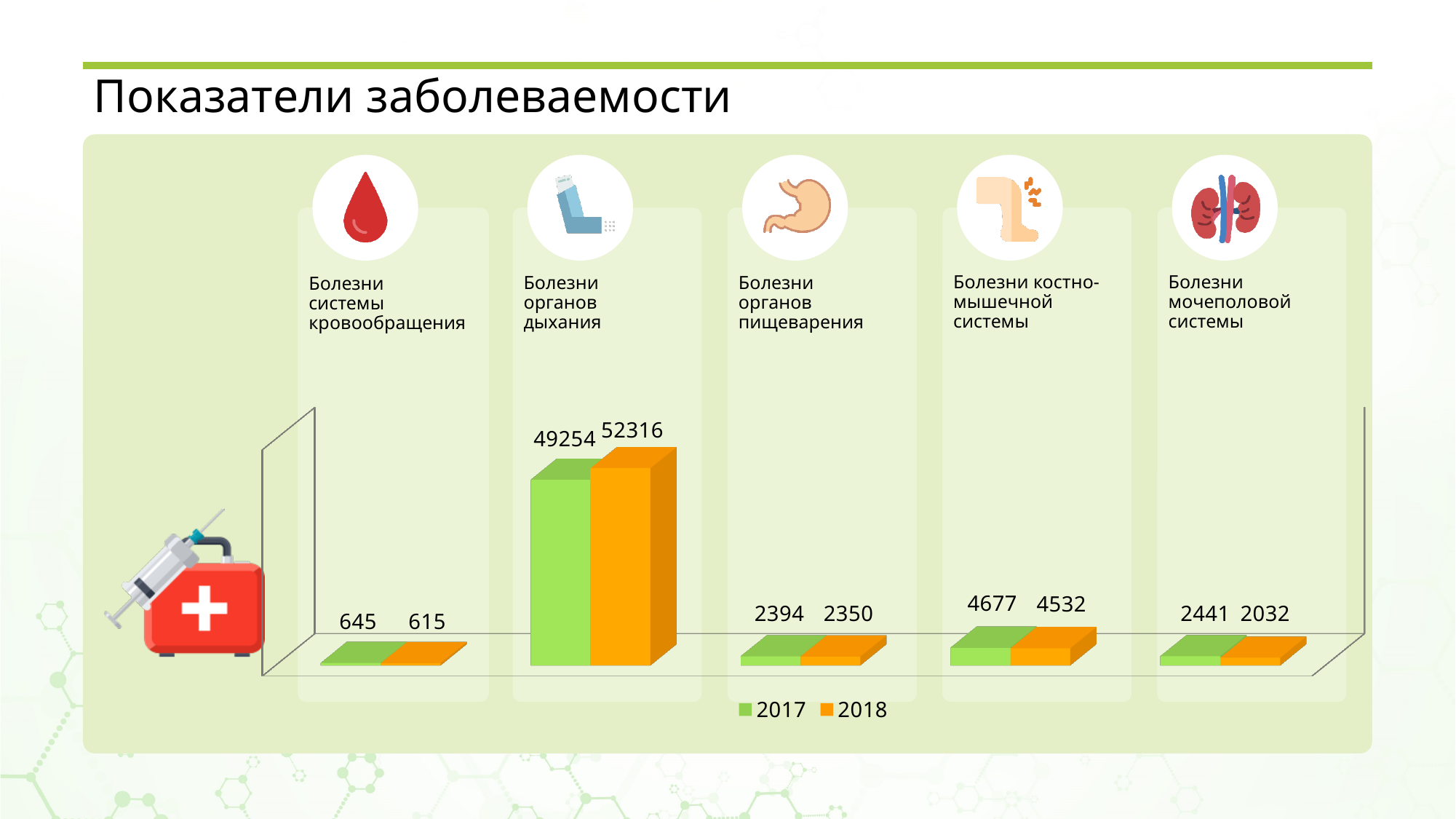
Which category has the lowest 2017 value? Болезни системы кровообращения How many disease categories are shown in the chart? 5 Which is larger for Болезни органов пищеварения: the 2017 value or the 2018 value? 2017 Which category has the highest 2018 value? Болезни органов дыхания What is the 2017 value for Болезни органов дыхания? 49254 What kind of chart is shown on the slide? Bar chart What is the difference between the 2017 and 2018 values for Болезни мочеполовой системы? 409 What is the 2017 value for Болезни костно-мышечной системы? 4677 What is the difference between the 2018 and 2017 values for Болезни органов дыхания? 3062 What is the 2018 value for Болезни мочеполовой системы? 2032 What is the 2018 value for Болезни системы кровообращения? 615 How many series does the legend list? 2